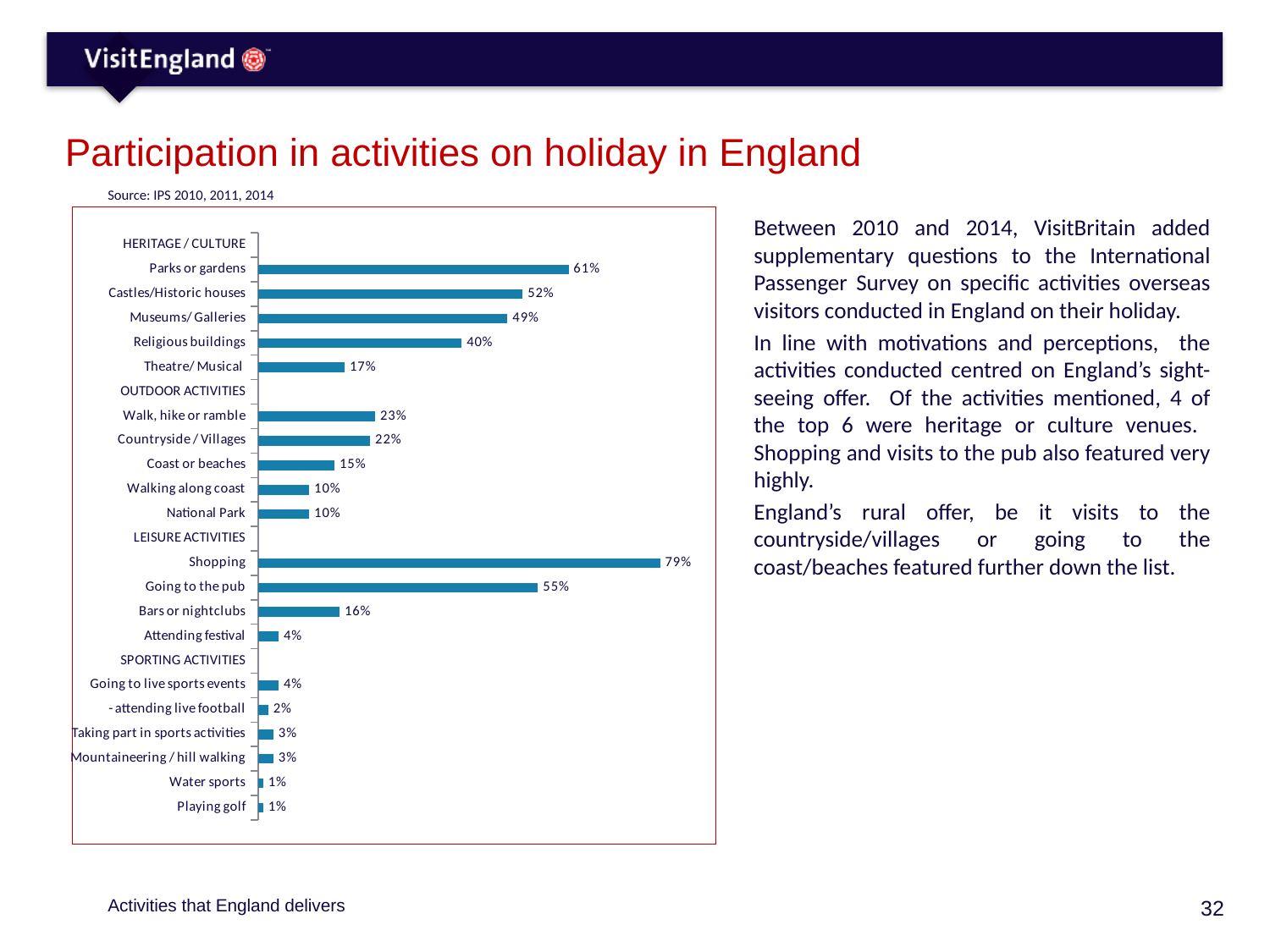
What is the participation value for Shopping? 79% What is the value for Walk, hike or ramble? 23% Which is larger, the value for Coast or beaches or the value for Bars or nightclubs? Bars or nightclubs Which is larger, the value for Religious buildings or the value for Theatre/Musical? Religious buildings How many activities have a plotted bar in the chart? 20 Which activity has the highest participation value? Shopping What source is cited for the chart? IPS 2010, 2011, 2014 What is the difference between the values for Shopping and Going to the pub? 24% What type of chart is shown on the slide? bar chart What is the value for Going to the pub? 55% What is the difference between the values for Castles/Historic houses and Museums/Galleries? 3% What is the value for Parks or gardens? 61%